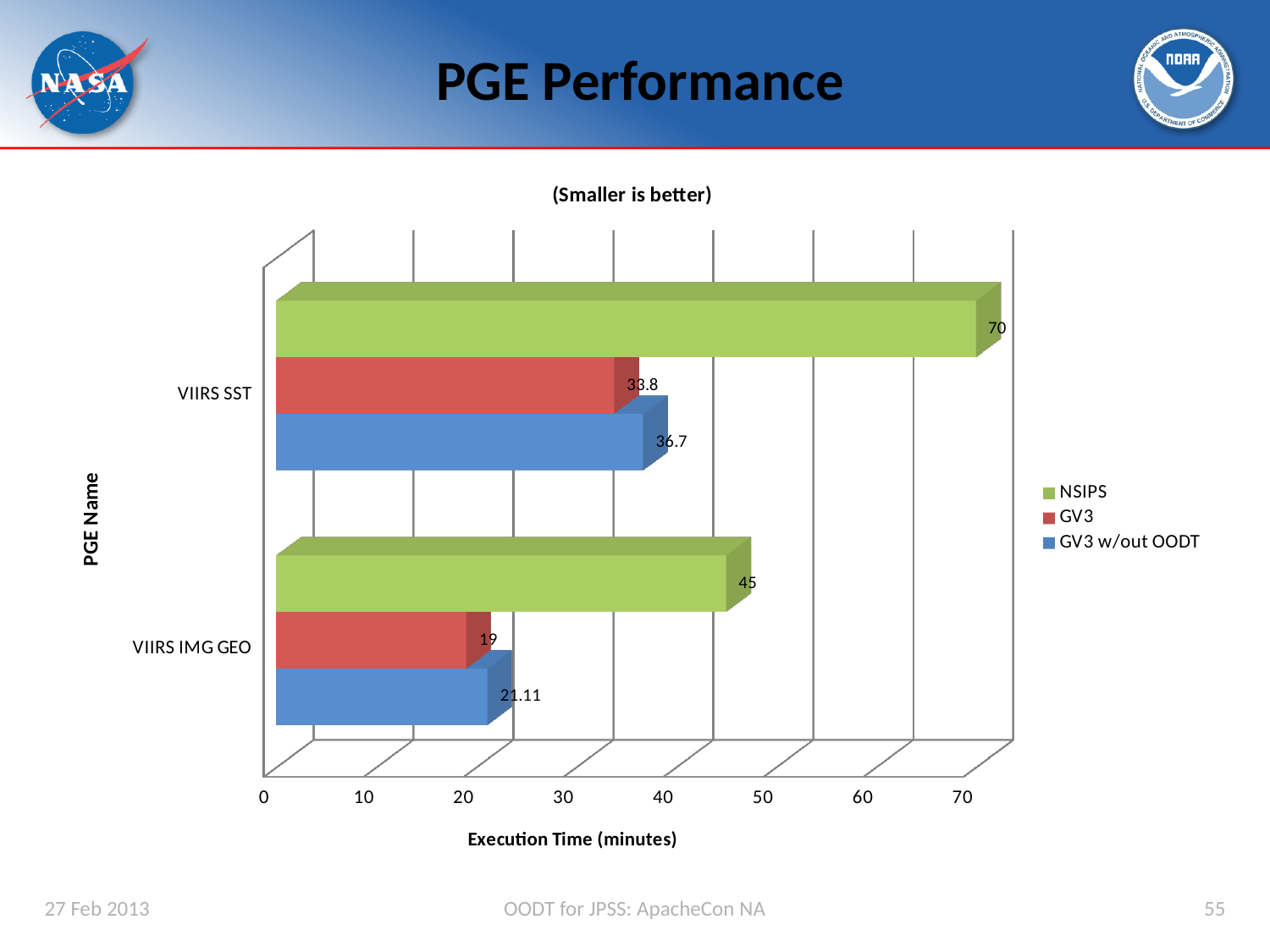
Which is larger for VIIRS IMG GEO: the GV3 value or the GV3 w/out OODT value? GV3 w/out OODT What is the difference between the NSIPS and GV3 execution times for VIIRS SST? 36.2 What is the GV3 execution time for VIIRS IMG GEO? 19 How many PGE names are shown on the chart? 2 Is the NSIPS value for VIIRS IMG GEO greater or less than 40? greater What is the GV3 w/out OODT execution time for VIIRS IMG GEO? 21.11 What is the NSIPS execution time for VIIRS SST? 70 Which series has the highest execution time for VIIRS SST? NSIPS Which series has the lowest execution time for VIIRS IMG GEO? GV3 How many series does the legend list? 3 What is the GV3 w/out OODT execution time for VIIRS SST? 36.7 What kind of chart is shown on the slide? Bar chart